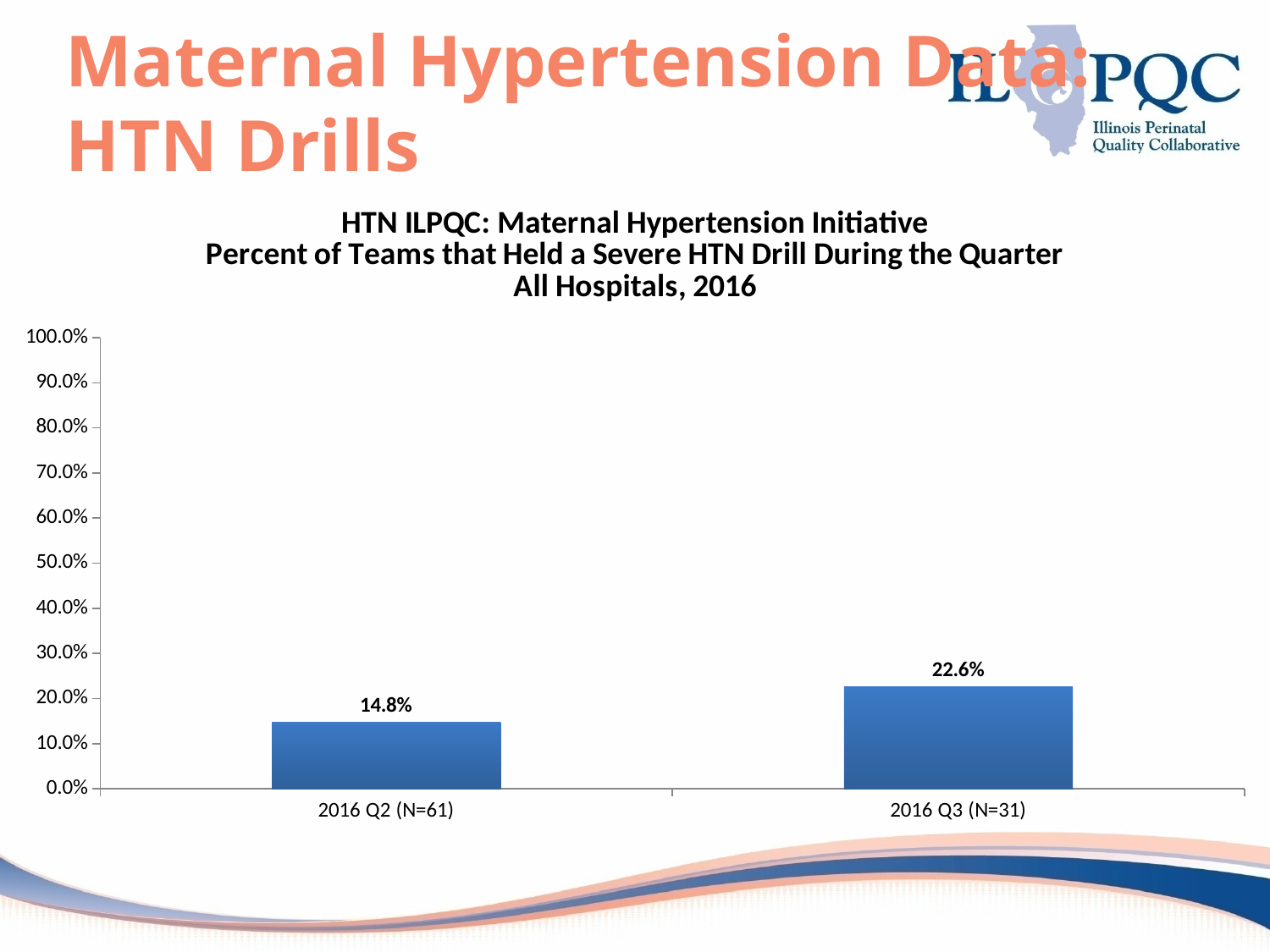
Do the values rise or fall from 2016 Q2 to 2016 Q3? Rise What kind of chart is shown on the slide? Bar chart Is the value for 2016 Q2 (N=61) greater or less than 20.0%? less What is the value for 2016 Q3 (N=31)? 22.6% What is the value for 2016 Q2 (N=61)? 14.8% Which quarter has the highest percent of teams that held a severe HTN drill? 2016 Q3 (N=31) Is the value for 2016 Q3 (N=31) greater or less than 20.0%? greater What is the maximum value shown on the y axis? 100.0% Which quarter has the lowest percent of teams that held a severe HTN drill? 2016 Q2 (N=61) How many quarters are shown on the chart? 2 What is the difference in percentage points between 2016 Q3 and 2016 Q2? 7.8 Which is larger, the value for 2016 Q2 or the value for 2016 Q3? 2016 Q3